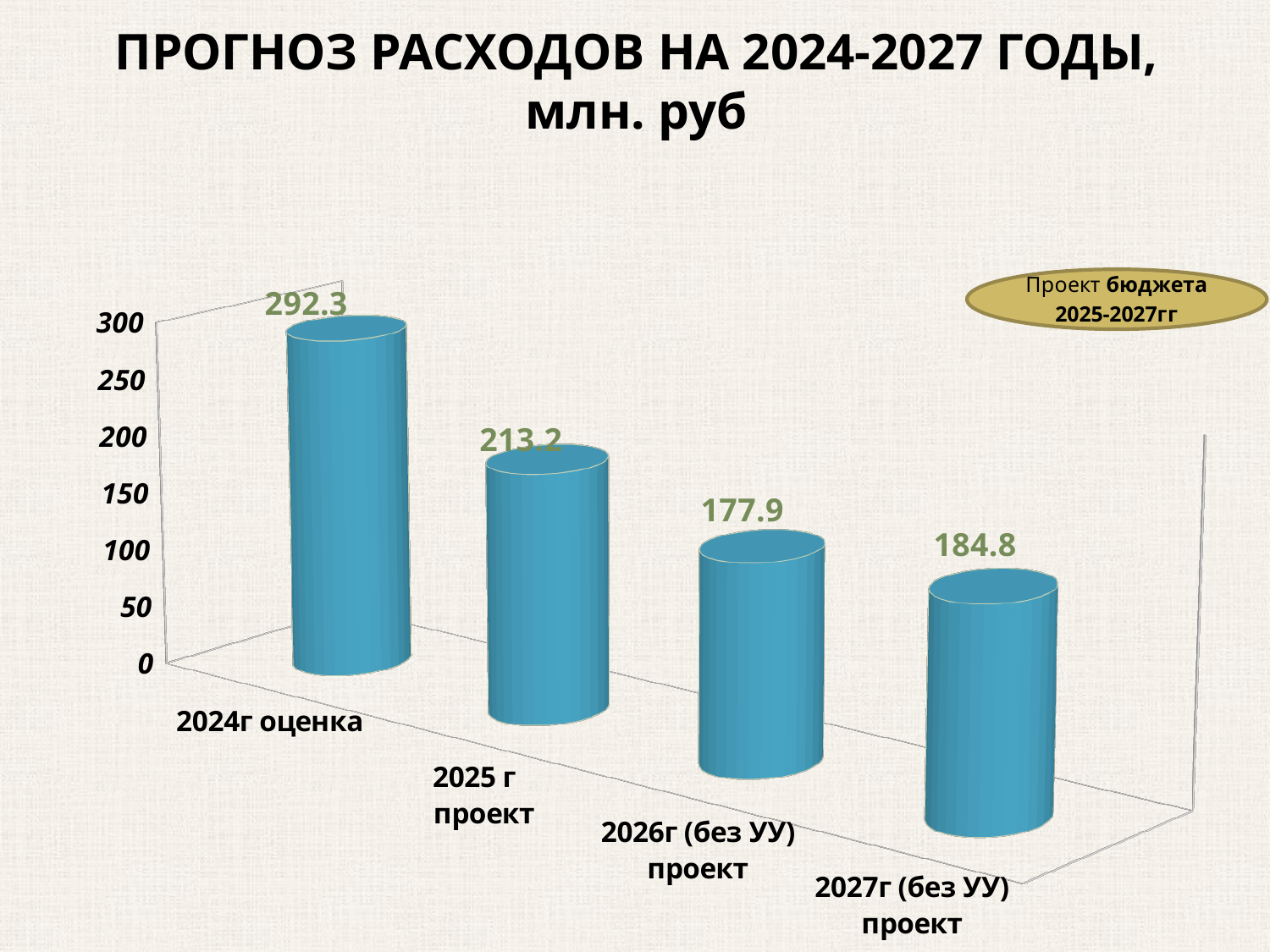
What is the value for 2027г (без УУ) проект? 184.8 What is the difference between the values for 2024г оценка and 2025 г проект? 79.1 What is the value for 2024г оценка? 292.3 How many categories are shown in the chart? 4 What is the value for 2025 г проект? 213.2 What is the title of the chart? ПРОГНОЗ РАСХОДОВ НА 2024-2027 ГОДЫ, млн. руб What is the difference between the values for 2027г (без УУ) проект and 2026г (без УУ) проект? 6.9 Which is larger, the value for 2025 г проект or the value for 2027г (без УУ) проект? 2025 г проект Which category has the highest value? 2024г оценка What kind of chart is shown on the slide? bar chart Which category has the lowest value? 2026г (без УУ) проект What is the value for 2026г (без УУ) проект? 177.9